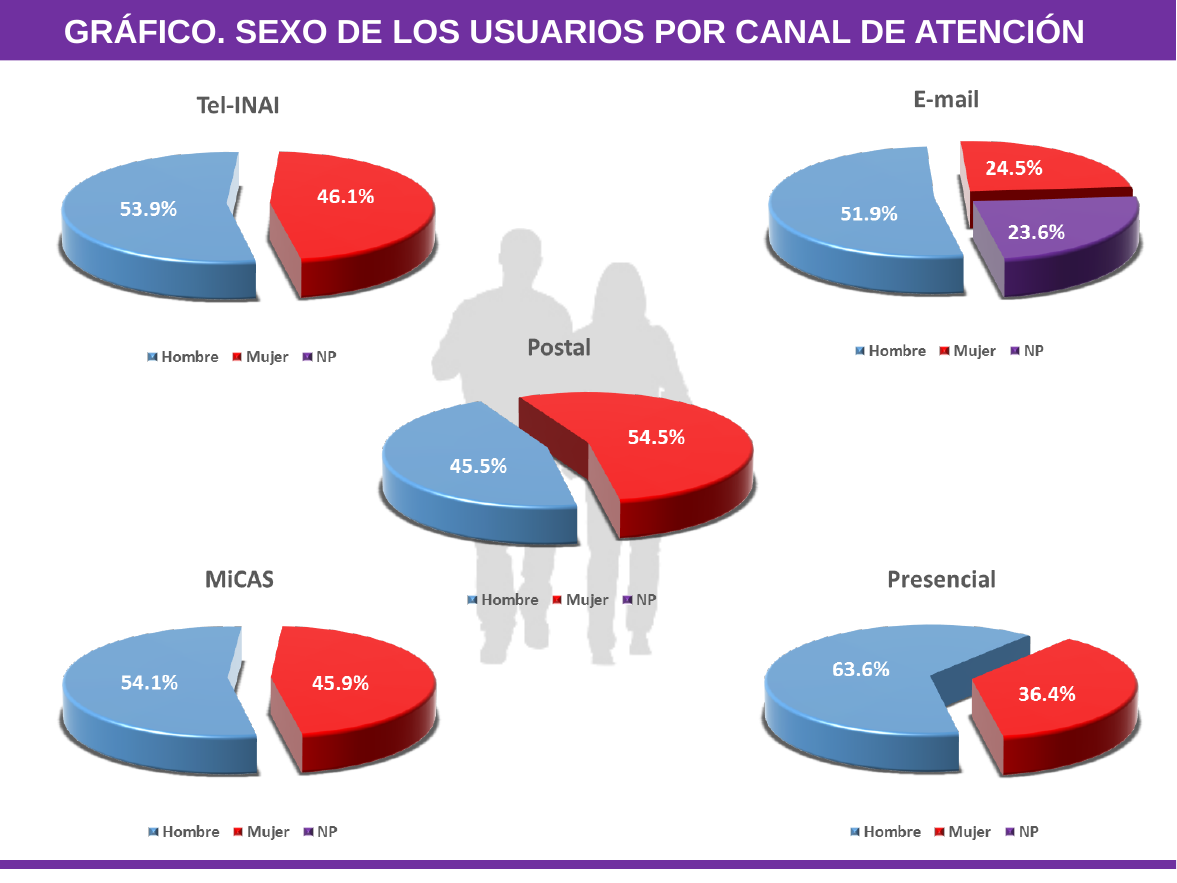
In the MiCAS chart, which category has the largest slice? Hombre In the Presencial chart, what is the difference between the Hombre and Mujer values? 27.2% How many series does the legend of the Tel-INAI chart list? 3 In the Postal chart, which is larger, Hombre or Mujer? Mujer How many slices does the E-mail pie chart have? 3 In the Presencial chart, what is the value for Hombre? 63.6% In the Tel-INAI chart, what is the value for Hombre? 53.9% In the Postal chart, what is the value for Mujer? 54.5% In the E-mail chart, which category has the smallest slice? NP What kind of chart is the MiCAS chart? Pie chart In the E-mail chart, what is the value for NP? 23.6% How many pie charts are shown on the slide? 5